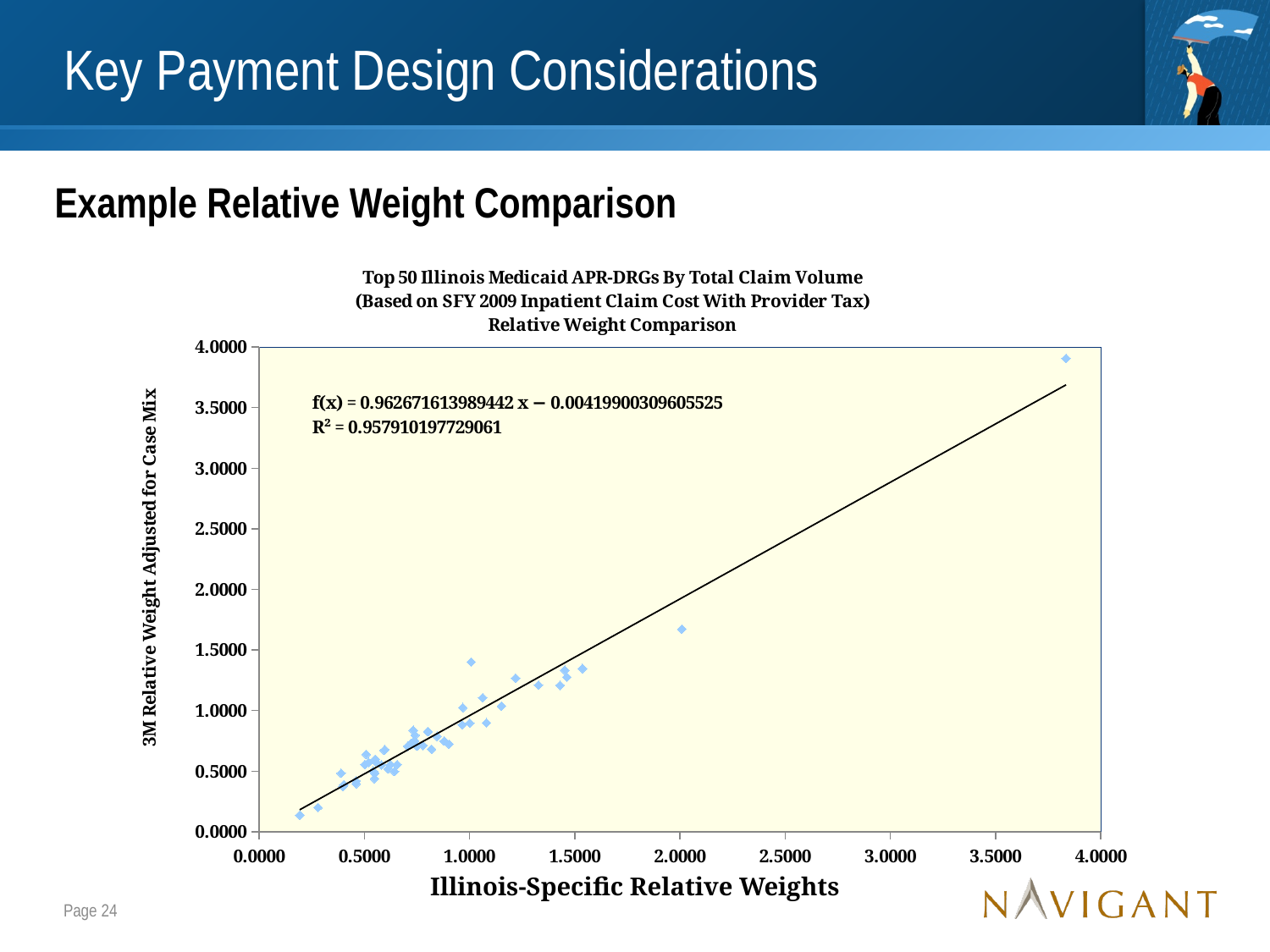
What is the title of the y axis? 3M Relative Weight Adjusted for Case Mix According to the chart title, how many APR-DRGs are plotted? 50 What is the highest tick value shown on the x axis? 4.0000 Do the plotted points generally rise or fall as the Illinois-Specific Relative Weight increases along the x axis? rise What is the title of the x axis? Illinois-Specific Relative Weights What is the interval between consecutive tick marks on the y axis? 0.5000 What kind of chart is shown on the slide? scatter plot What is the constant term in the trendline equation f(x) printed on the chart? −0.00419900309605525 What is the R² value printed on the chart? 0.957910197729061 Is the 3M Relative Weight of the point plotted near an Illinois-Specific Relative Weight of 2.0000 greater or less than 2.0000? less Is the 3M Relative Weight of the highest plotted point greater or less than 3.5000? greater What is the slope coefficient of x in the trendline equation f(x) printed on the chart? 0.962671613989442